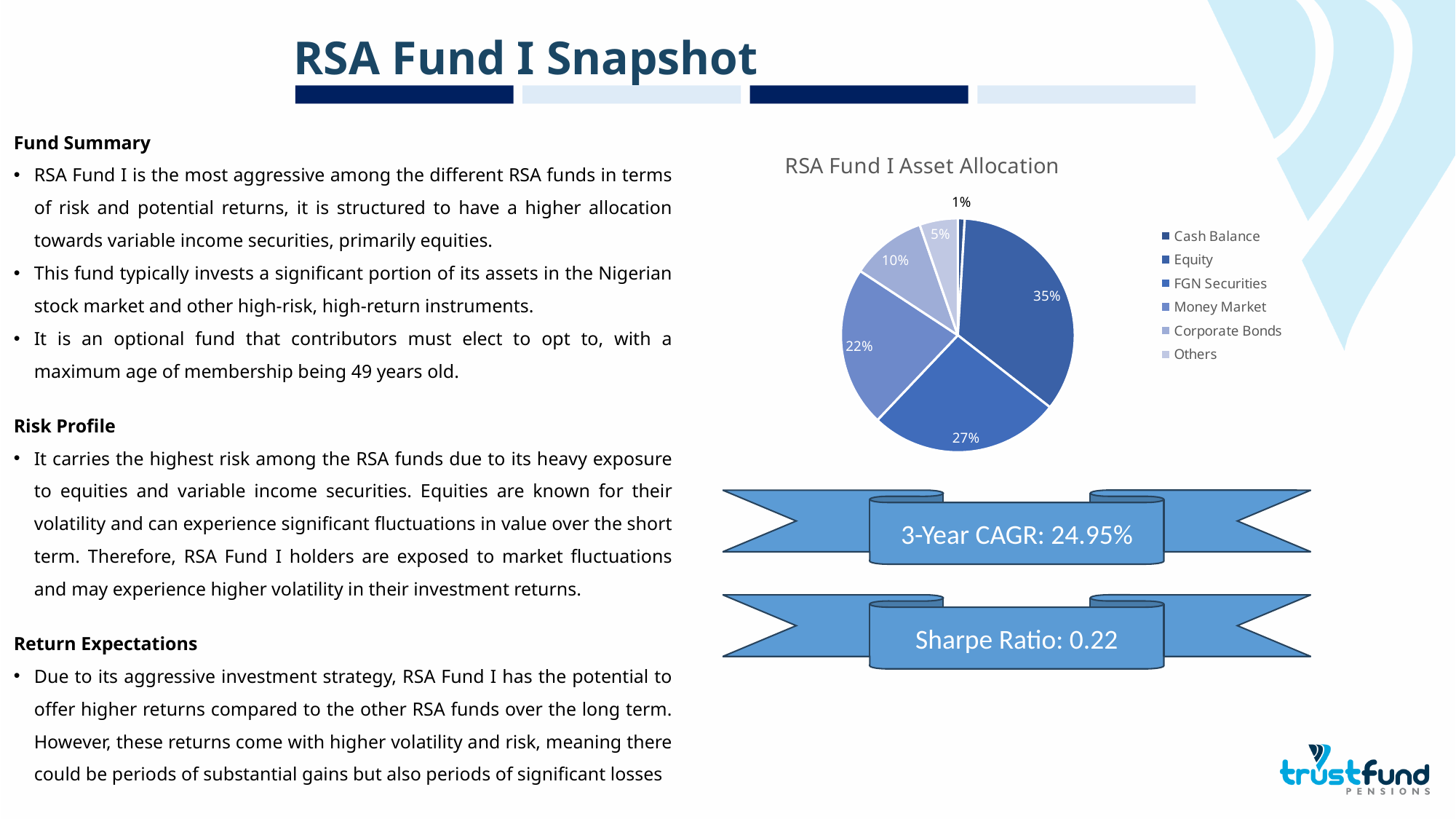
What share of the pie does Money Market represent? 22% What is the difference in percentage points between the Equity and FGN Securities slices? 8 What share of the pie does FGN Securities represent? 27% Which category has the smallest slice of the pie? Cash Balance What share of the pie does Corporate Bonds represent? 10% What is the title of the pie chart? RSA Fund I Asset Allocation Which is larger, the Money Market slice or the Corporate Bonds slice? Money Market What kind of chart is shown on the slide? pie chart Which category has the largest slice of the pie? Equity How many categories does the legend of the pie chart list? 6